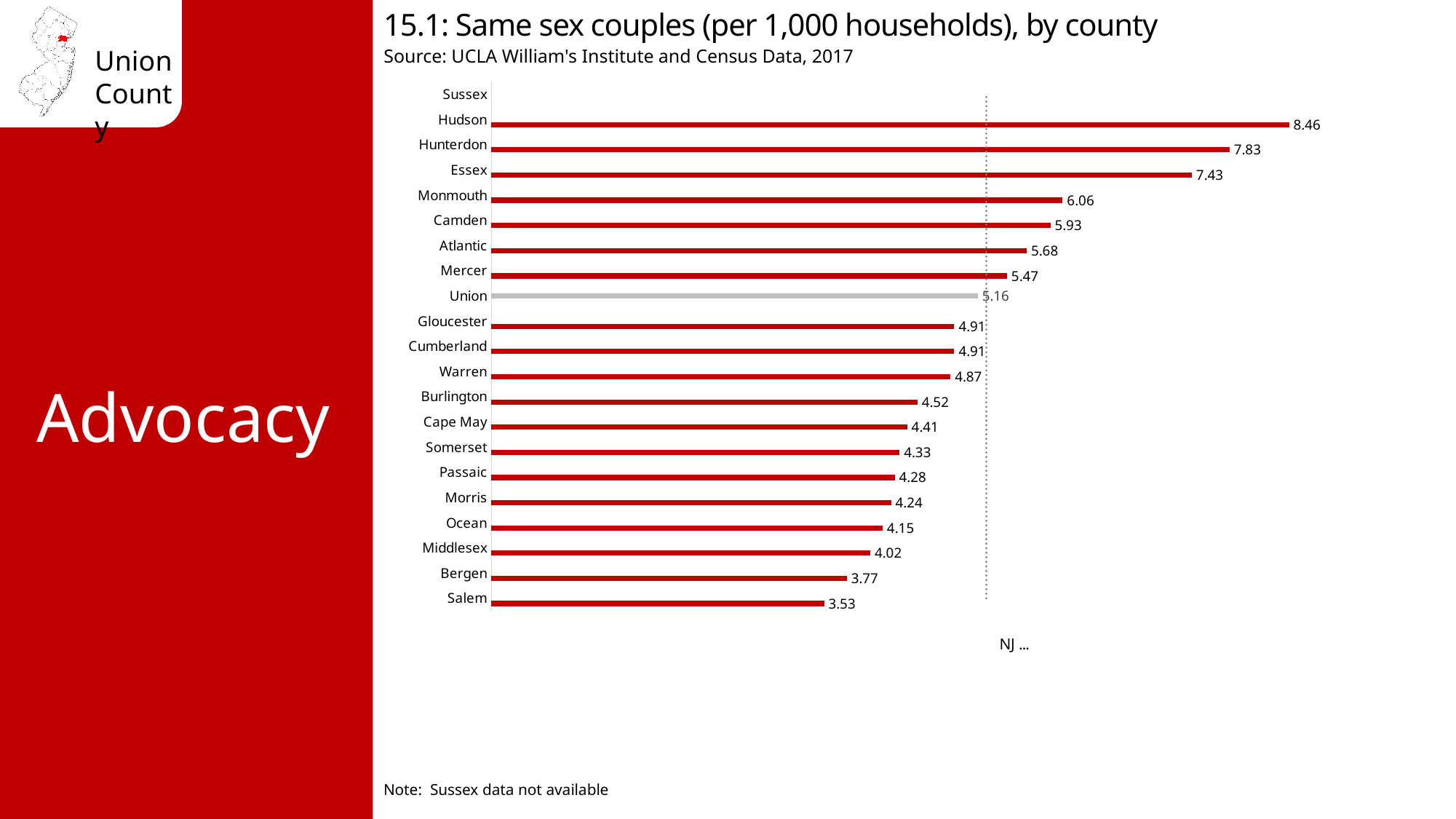
What is the value for Hudson? 8.46 What is the difference between the values for Union and Mercer? 0.31 Which county has the lowest plotted value? Salem Which county has no data shown, according to the note? Sussex How many counties are listed on the y axis? 21 What is the difference between the values for Hudson and Hunterdon? 0.63 Which is larger, the value for Essex or the value for Monmouth? Essex What kind of chart is this? Bar chart What is the value for Union? 5.16 What is the value for Cape May? 4.41 What is the value for Salem? 3.53 Which county has the highest value? Hudson